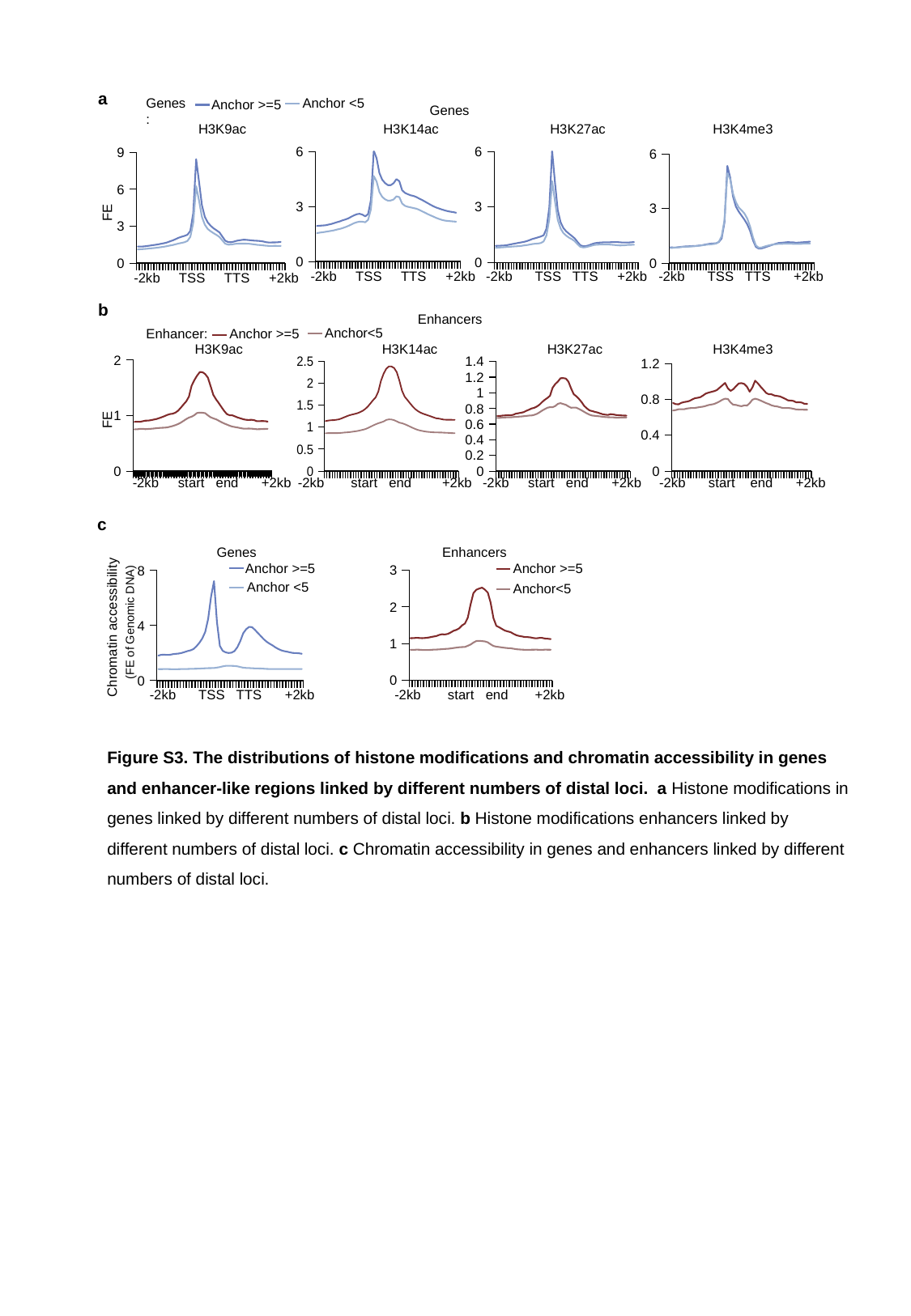
In panel b H3K27ac chart, which series is higher at the centre of the enhancer region, Anchor >=5 or Anchor<5? Anchor >=5 In panel a, is the peak value of the Anchor >=5 line at the TSS in the H3K9ac chart greater or less than 6? greater How many charts are shown in panel a (Genes)? 4 In panel c, is the peak value of the Anchor >=5 line at the TSS in the Genes chart greater or less than 4? greater In panel c, how many series does the legend of the Genes chart list? 2 In panel c Genes chart, which series reaches the higher peak at the TSS, Anchor >=5 or Anchor <5? Anchor >=5 In panel a, is the peak value of the Anchor >=5 line in the H3K4me3 chart greater or less than 3? greater What is the y-axis label of the charts in panel c? Chromatin accessibility (FE of Genomic DNA) In panel a, what kind of chart is the H3K9ac chart? line chart